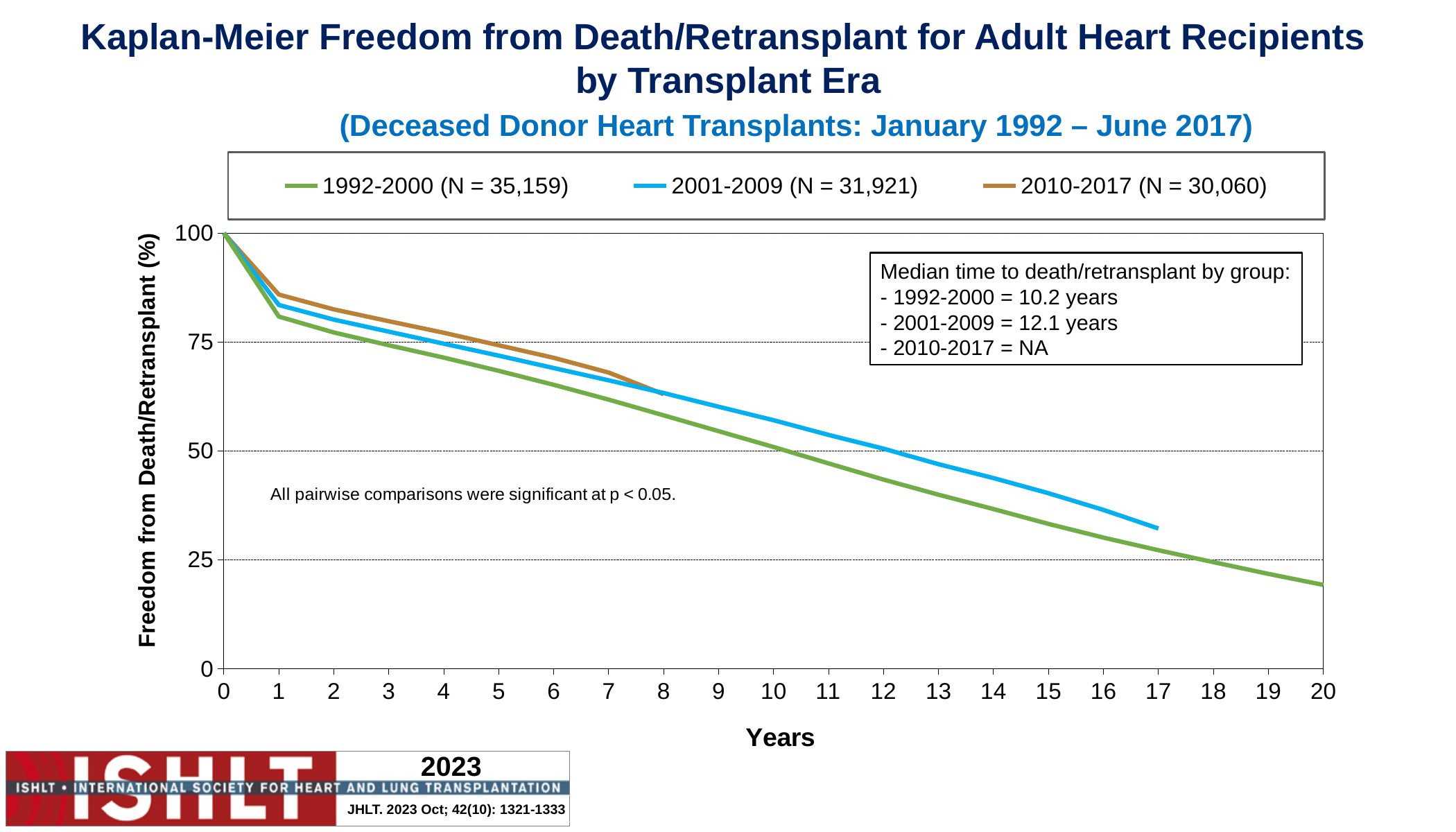
What is the median time to death/retransplant for the 2010-2017 group? NA What is the N for the 2001-2009 series in the legend? 31,921 How many series does the legend list? 3 Do the curves rise or fall as the years increase along the x axis? Fall Which transplant era has the highest freedom from death/retransplant at year 5? 2010-2017 Is the freedom from death/retransplant for the 2001-2009 group at year 17 greater or less than 25? greater How much longer is the median time to death/retransplant for 2001-2009 than for 1992-2000? 1.9 years At year 3, which has the higher freedom from death/retransplant: the 1992-2000 group or the 2010-2017 group? 2010-2017 What kind of chart is shown on the slide? Line chart What is the median time to death/retransplant for the 1992-2000 group? 10.2 years Is the freedom from death/retransplant for the 1992-2000 group at year 20 greater or less than 25? less What is the median time to death/retransplant for the 2001-2009 group? 12.1 years